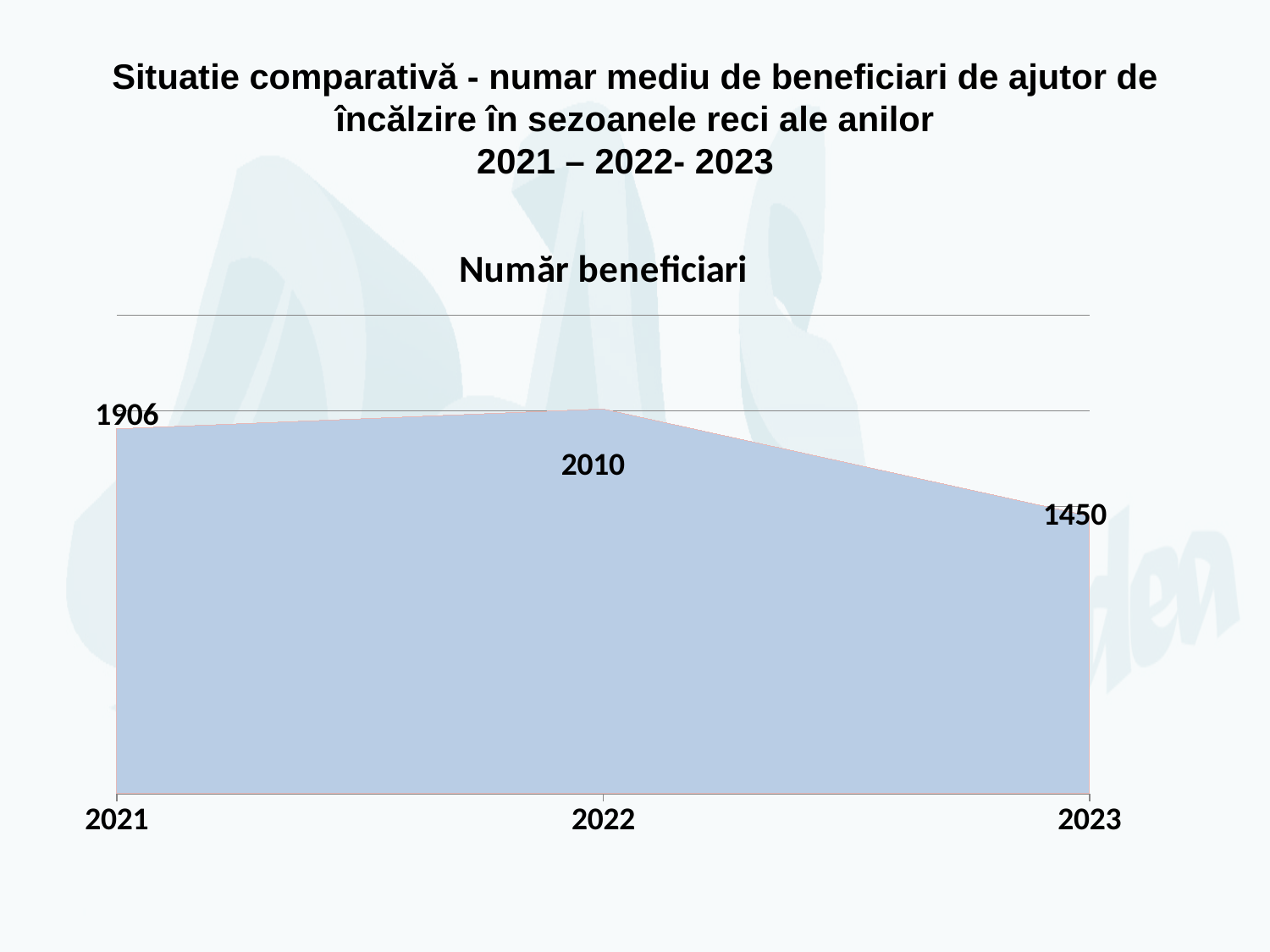
What is the difference between the values for 2022 and 2021? 104 What is the value for 2023? 1450 What is the value for 2021? 1906 Which is larger, the value for 2021 or the value for 2023? 2021 Which year has the highest number of beneficiaries? 2022 Which year has the lowest number of beneficiaries? 2023 How many years are plotted on the chart? 3 What is the value for 2022? 2010 What kind of chart is shown? area chart What is the difference between the values for 2022 and 2023? 560 Does the value rise or fall from 2022 to 2023? fall What is the title of the chart? Număr beneficiari